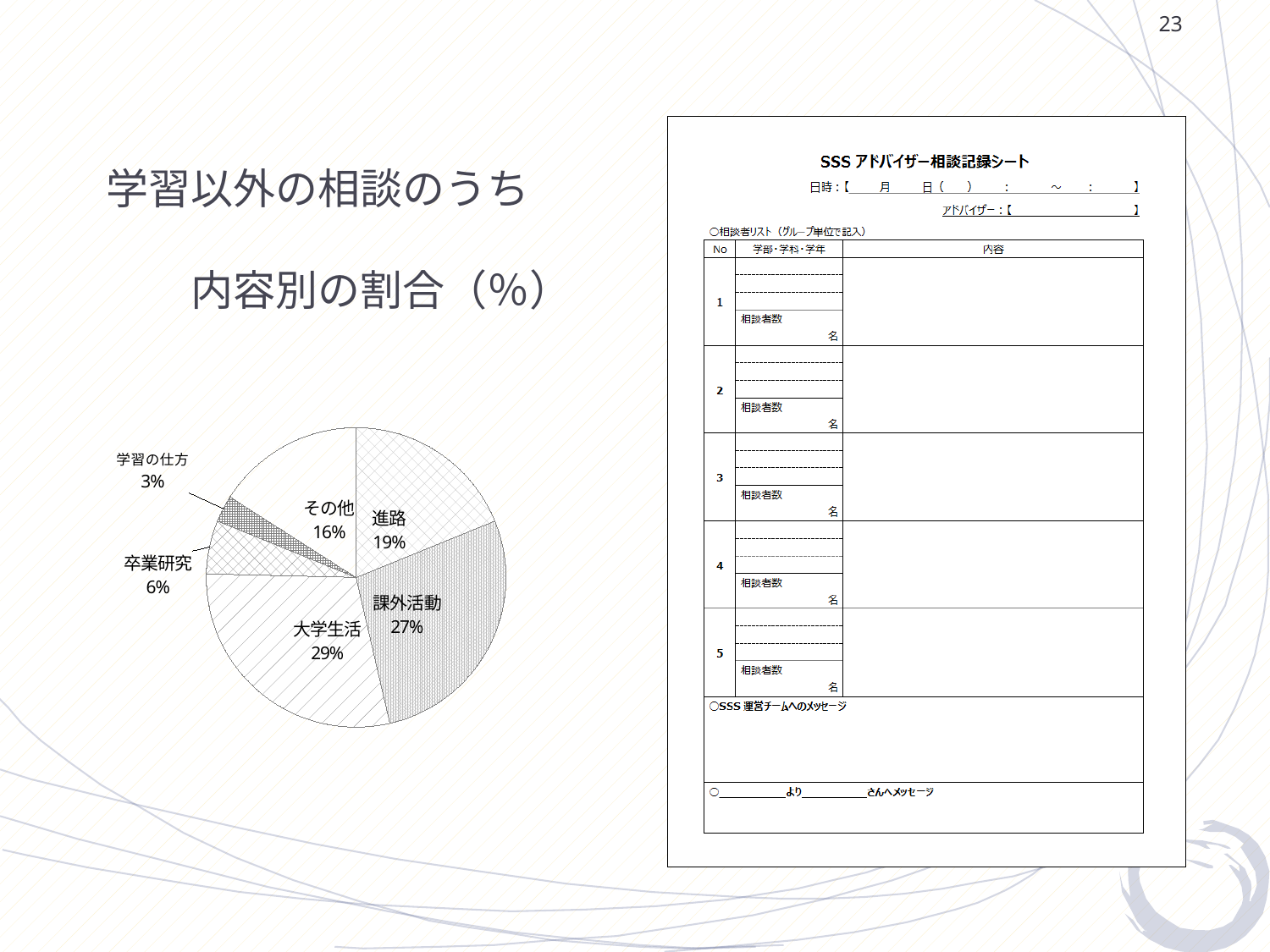
What is the difference in percentage points between 進路 and その他? 3 Which category has the smallest share of the pie? 学習の仕方 What percentage does the 進路 slice show? 19% Which category has the largest share of the pie? 大学生活 What percentage does the 課外活動 slice show? 27% What kind of chart is shown on the slide? pie chart What percentage does the 大学生活 slice show? 29% What is the title of the chart on the slide? 学習以外の相談のうち 内容別の割合（%） How many slices does the pie chart have? 6 What percentage does the 学習の仕方 slice show? 3% Which is larger, the share for 卒業研究 or the share for その他? その他 What is the difference in percentage points between 大学生活 and 課外活動? 2